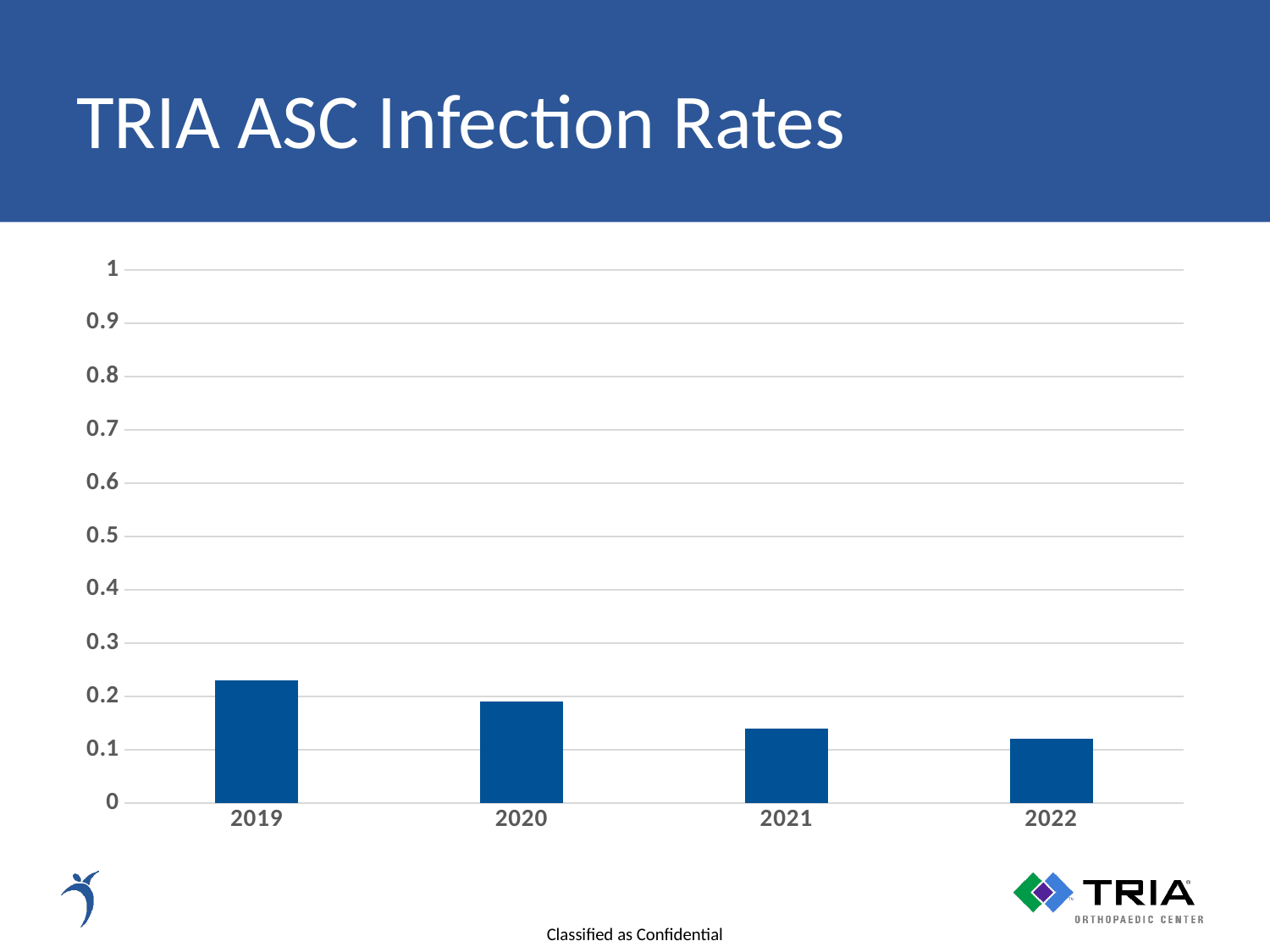
Which is larger, the value for 2019 or the value for 2022? 2019 Is the value for 2019 greater or less than 0.3? less What type of chart is shown on the slide? bar chart Do the infection rates rise or fall from 2019 to 2022? fall Which is larger, the value for 2020 or the value for 2021? 2020 Is the value for 2019 greater or less than 0.2? greater Is the value for 2021 greater or less than 0.1? greater How many years are shown on the x axis of the chart? 4 What is the title of the slide containing the chart? TRIA ASC Infection Rates Which year has the highest infection rate in the chart? 2019 Which year has the lowest infection rate in the chart? 2022